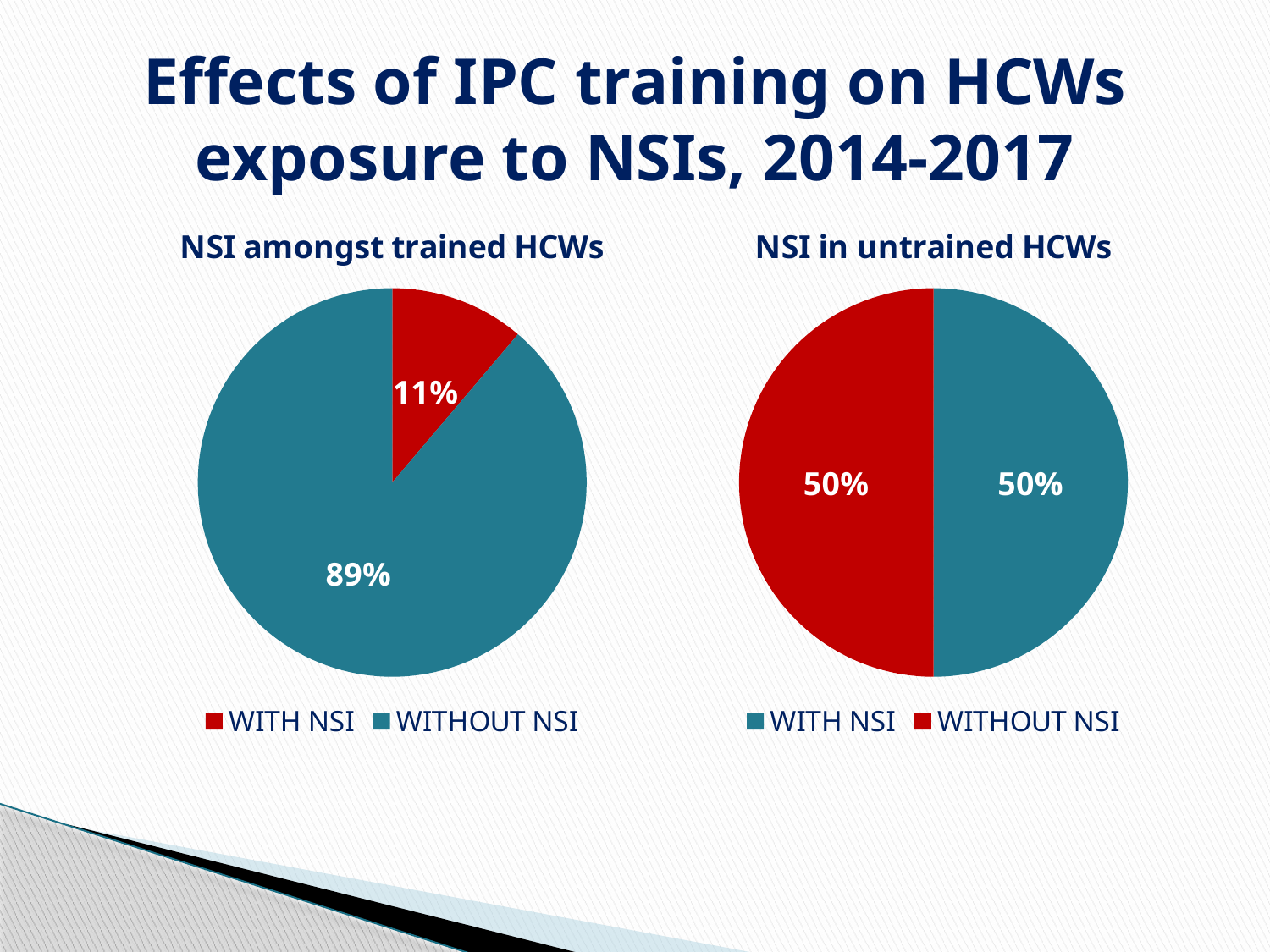
In the 'NSI amongst trained HCWs' chart, which category has the smallest slice? WITH NSI In the 'NSI amongst trained HCWs' chart, which category has the largest slice? WITHOUT NSI In the 'NSI amongst trained HCWs' chart, what percentage is shown for WITH NSI? 11% In the 'NSI amongst trained HCWs' chart, which is larger, WITH NSI or WITHOUT NSI? WITHOUT NSI In the 'NSI amongst trained HCWs' chart, what is the difference in percentage points between WITHOUT NSI and WITH NSI? 78 How many slices does the 'NSI amongst trained HCWs' pie chart have? 2 In the 'NSI in untrained HCWs' chart, what percentage is shown for WITH NSI? 50% In the 'NSI in untrained HCWs' chart, what percentage is shown for WITHOUT NSI? 50% In the 'NSI amongst trained HCWs' chart, what colour is the WITH NSI slice? Red In the 'NSI amongst trained HCWs' chart, what percentage is shown for WITHOUT NSI? 89% What type of chart is used for 'NSI in untrained HCWs'? Pie chart How many entries does the legend of the 'NSI in untrained HCWs' chart list? 2